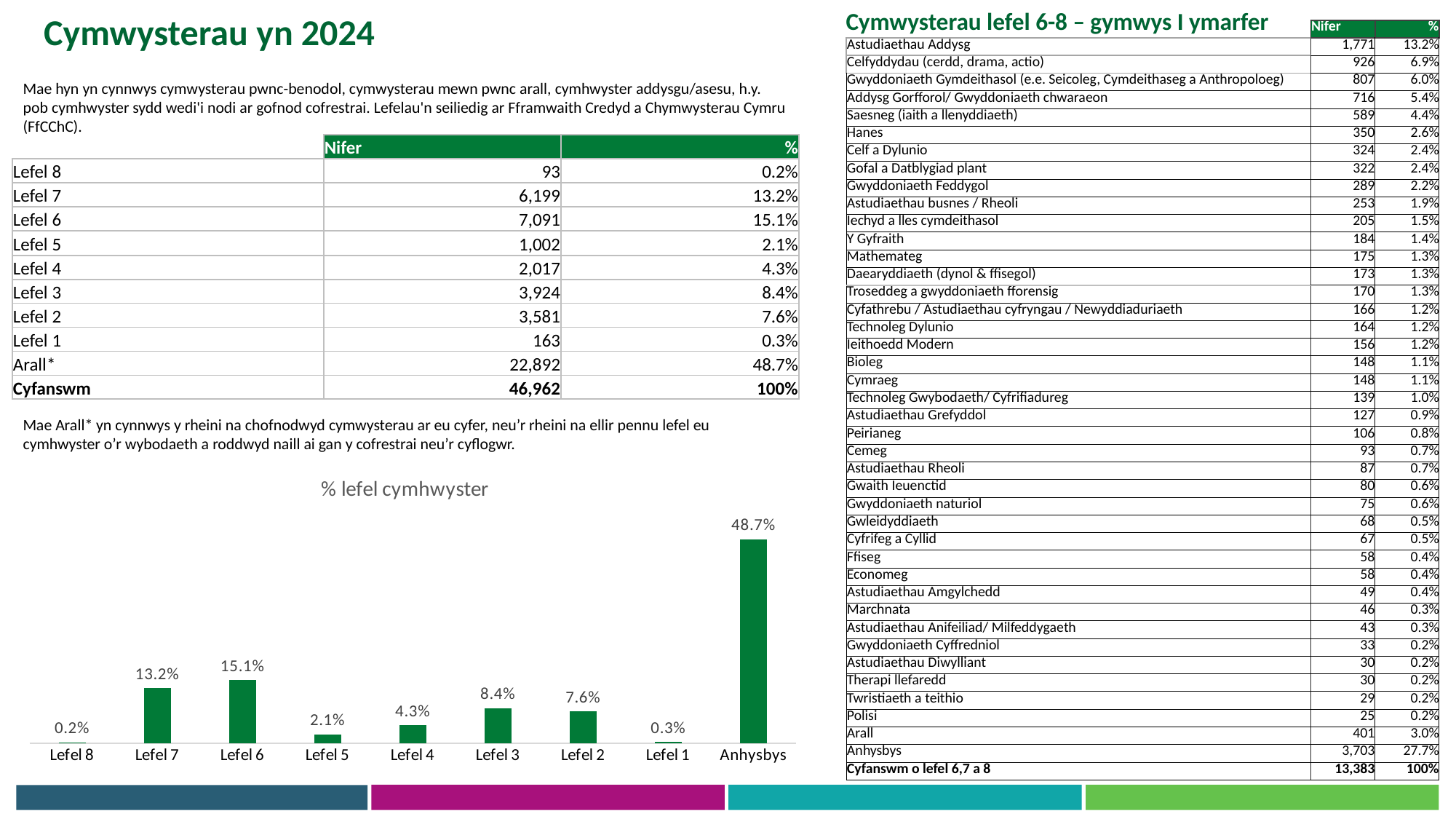
What is the value for Lefel 3 in the chart? 8.4% What type of chart is shown on the slide? bar chart Which category has the lowest value in the chart? Lefel 8 What is the difference between the values for Anhysbys and Lefel 6? 33.6% How many categories are plotted in the chart? 9 What is the difference between the values for Lefel 6 and Lefel 7? 1.9% What is the value for Anhysbys in the chart? 48.7% What is the title of the chart? % lefel cymhwyster What is the value for Lefel 6 in the chart? 15.1% Which category has the highest value in the chart? Anhysbys Which is larger, the value for Lefel 3 or the value for Lefel 2? Lefel 3 What is the value for Lefel 1 in the chart? 0.3%